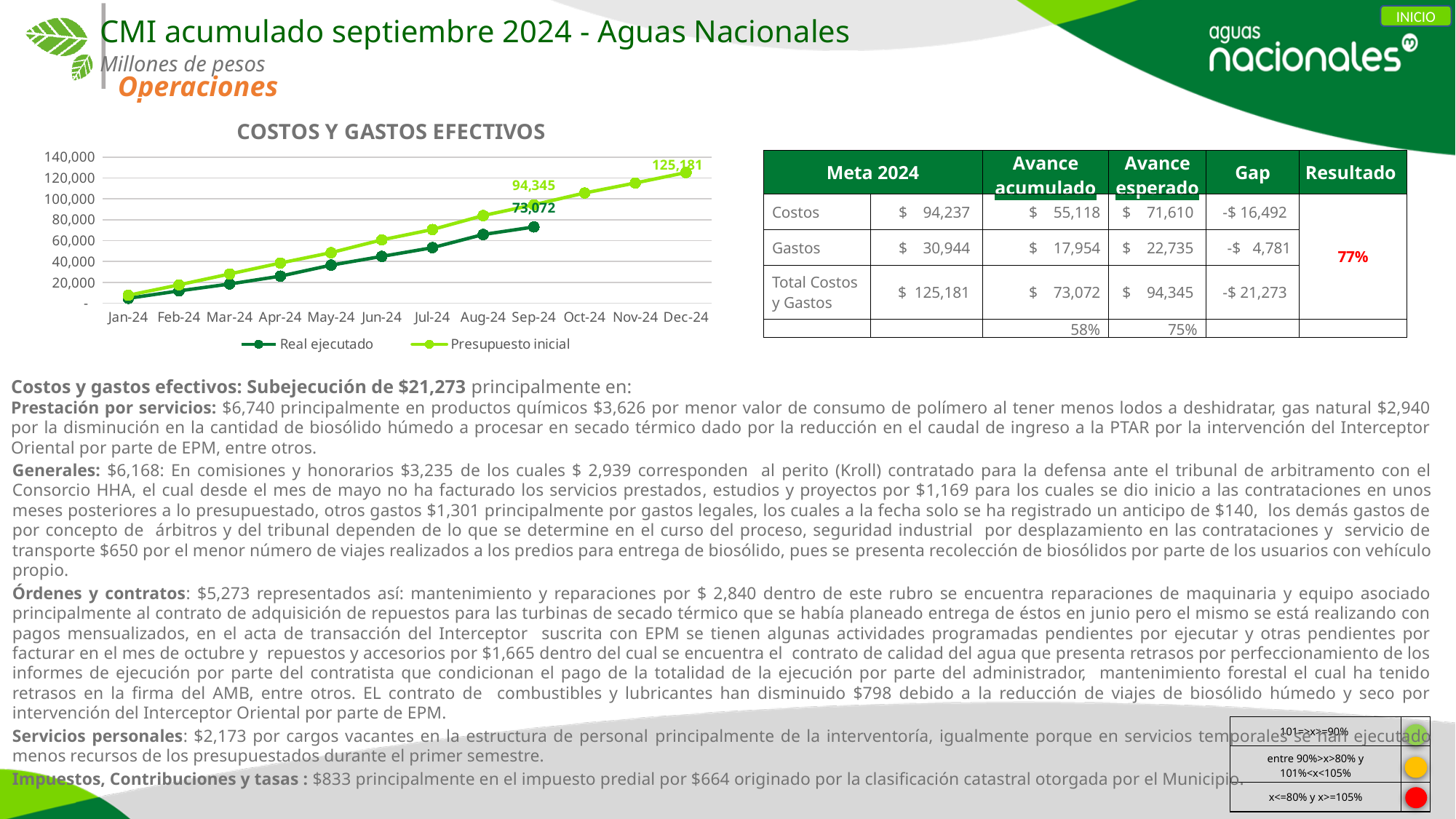
In the COSTOS Y GASTOS EFECTIVOS chart, what is the difference between Presupuesto inicial and Real ejecutado at Sep-24? 21,273 In the COSTOS Y GASTOS EFECTIVOS chart, what is the value of Presupuesto inicial at Dec-24? 125,181 In the COSTOS Y GASTOS EFECTIVOS chart, what is the value of Presupuesto inicial at Sep-24? 94,345 In the COSTOS Y GASTOS EFECTIVOS chart, what is the value of Real ejecutado at Sep-24? 73,072 In the COSTOS Y GASTOS EFECTIVOS chart, which series has the larger value at Sep-24, Real ejecutado or Presupuesto inicial? Presupuesto inicial In the COSTOS Y GASTOS EFECTIVOS chart, is the value for Presupuesto inicial at Nov-24 greater or less than 100,000? greater In the COSTOS Y GASTOS EFECTIVOS chart, which series is drawn in dark green? Real ejecutado How many series does the legend of the COSTOS Y GASTOS EFECTIVOS chart list? 2 In the COSTOS Y GASTOS EFECTIVOS chart, do the Presupuesto inicial values rise or fall from Jan-24 to Dec-24? Rise What kind of chart is shown under the title COSTOS Y GASTOS EFECTIVOS? Line chart In the COSTOS Y GASTOS EFECTIVOS chart, is the value for Real ejecutado at Jun-24 greater or less than 60,000? less How many months are shown on the x axis of the COSTOS Y GASTOS EFECTIVOS chart? 12